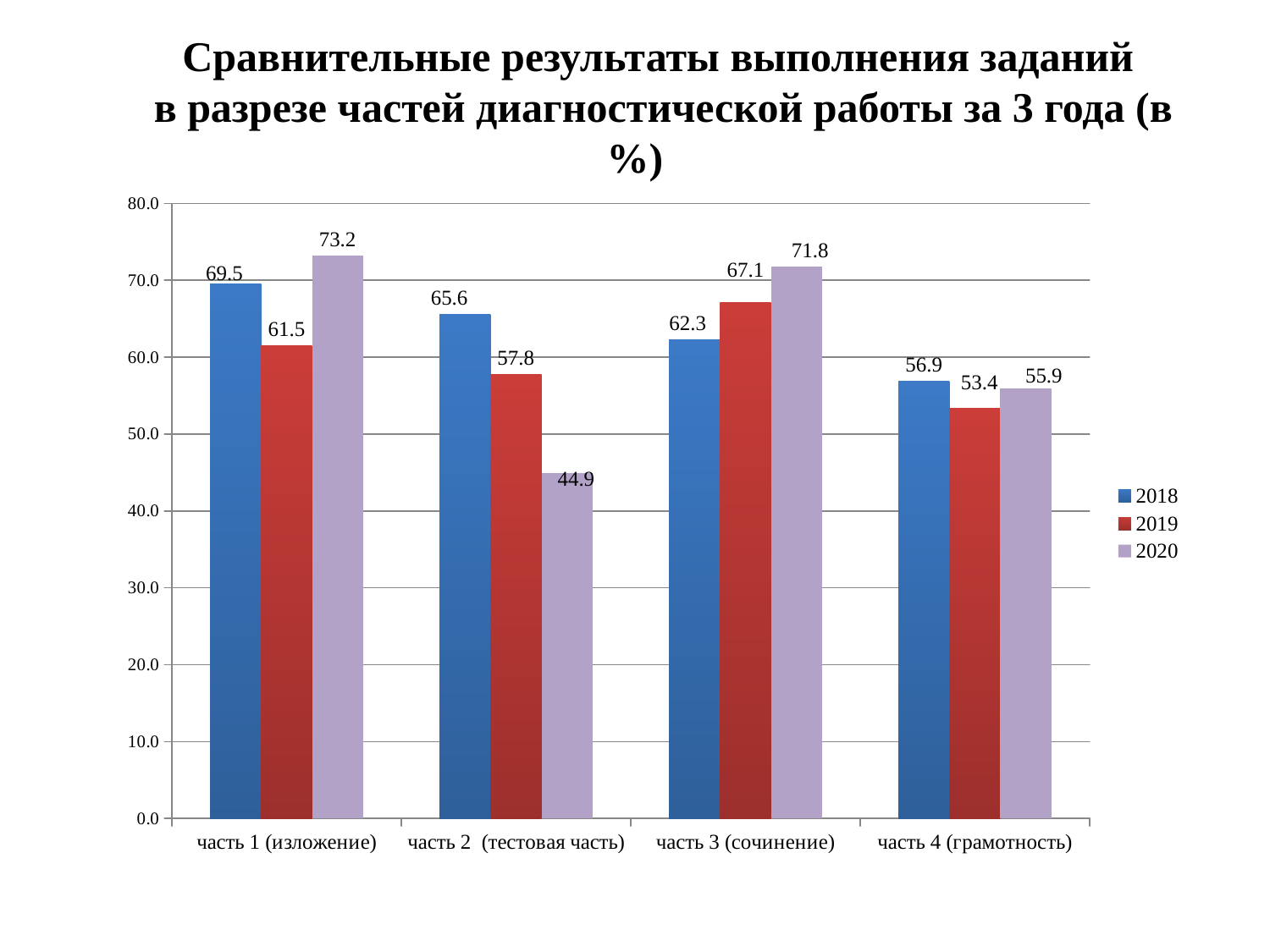
Which is larger in часть 3 (сочинение): the 2018 value or the 2019 value? 2019 Which series is shown in red in the legend? 2019 What is the value for 2019 in часть 2 (тестовая часть)? 57.8 How many series does the legend list? 3 What is the difference between the 2018 and 2020 values in часть 2 (тестовая часть)? 20.7 Which category has the lowest value for the 2020 series? часть 2 (тестовая часть) Is the value for 2019 in часть 4 (грамотность) greater or less than 60.0? less How many categories are shown on the x axis? 4 Which category has the highest value for the 2020 series? часть 1 (изложение) What kind of chart is shown on the slide? bar chart What is the value for 2018 in часть 4 (грамотность)? 56.9 What is the value for 2020 in часть 1 (изложение)? 73.2